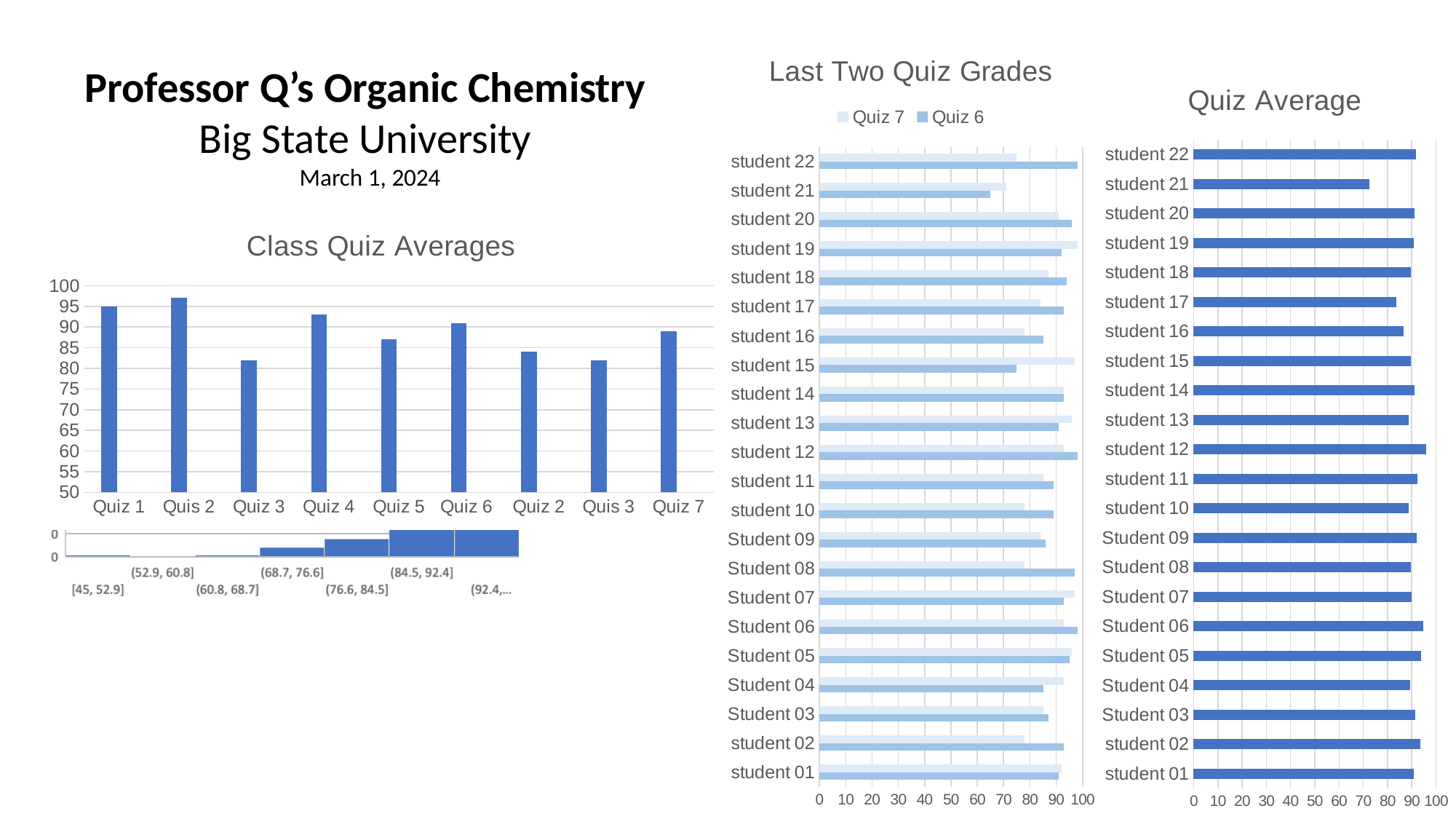
In the Class Quiz Averages chart, what kind of chart is used? bar chart In the Class Quiz Averages chart, is the value for Quiz 3 greater or less than 85? less In the Quiz Average chart, which student has the lowest average? student 21 In the Last Two Quiz Grades chart, is the Quiz 6 value for student 21 greater or less than 70? less In the Last Two Quiz Grades chart, how many series does the legend list? 2 In the Class Quiz Averages chart, which is larger, the value for Quiz 4 or the value for Quiz 2? Quiz 4 In the Class Quiz Averages chart, is the value for Quiz 5 greater or less than 85? greater In the Last Two Quiz Grades chart, what are the two series named in the legend? Quiz 7 and Quiz 6 In the Last Two Quiz Grades chart, how many students are listed on the vertical axis? 22 In the Class Quiz Averages chart, which category has the highest bar? Quis 2 In the Class Quiz Averages chart, how many quiz categories are shown on the x axis? 9